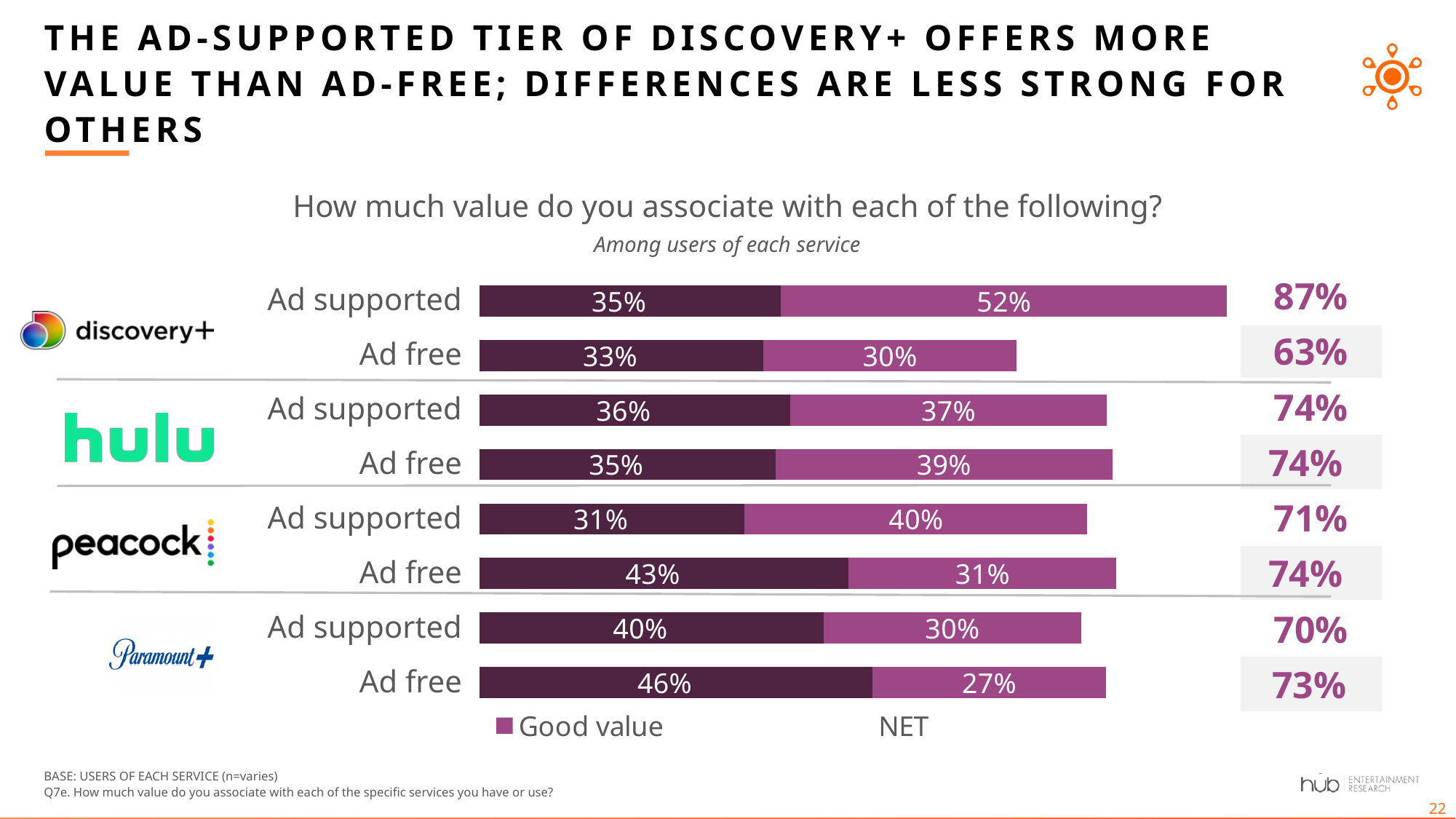
For Peacock, which tier has the higher NET value, Ad supported or Ad free? Ad free What is the value of the darker (left) segment of the Peacock Ad free bar? 43% What is the difference in NET value between the discovery+ Ad supported and Ad free tiers? 24 percentage points How many bars are plotted in the chart? 8 What is the NET value for the discovery+ Ad supported tier? 87% How many streaming services are compared in the chart? 4 What percentage of Hulu Ad free users rate it as Good value? 39% Which service and tier has the lowest NET value? discovery+ Ad free Which service and tier has the highest NET value? discovery+ Ad supported What is the NET value for the Paramount+ Ad free tier? 73% What type of chart is shown on the slide? Stacked bar chart What is the total of the two segments in the Paramount+ Ad supported bar? 70%